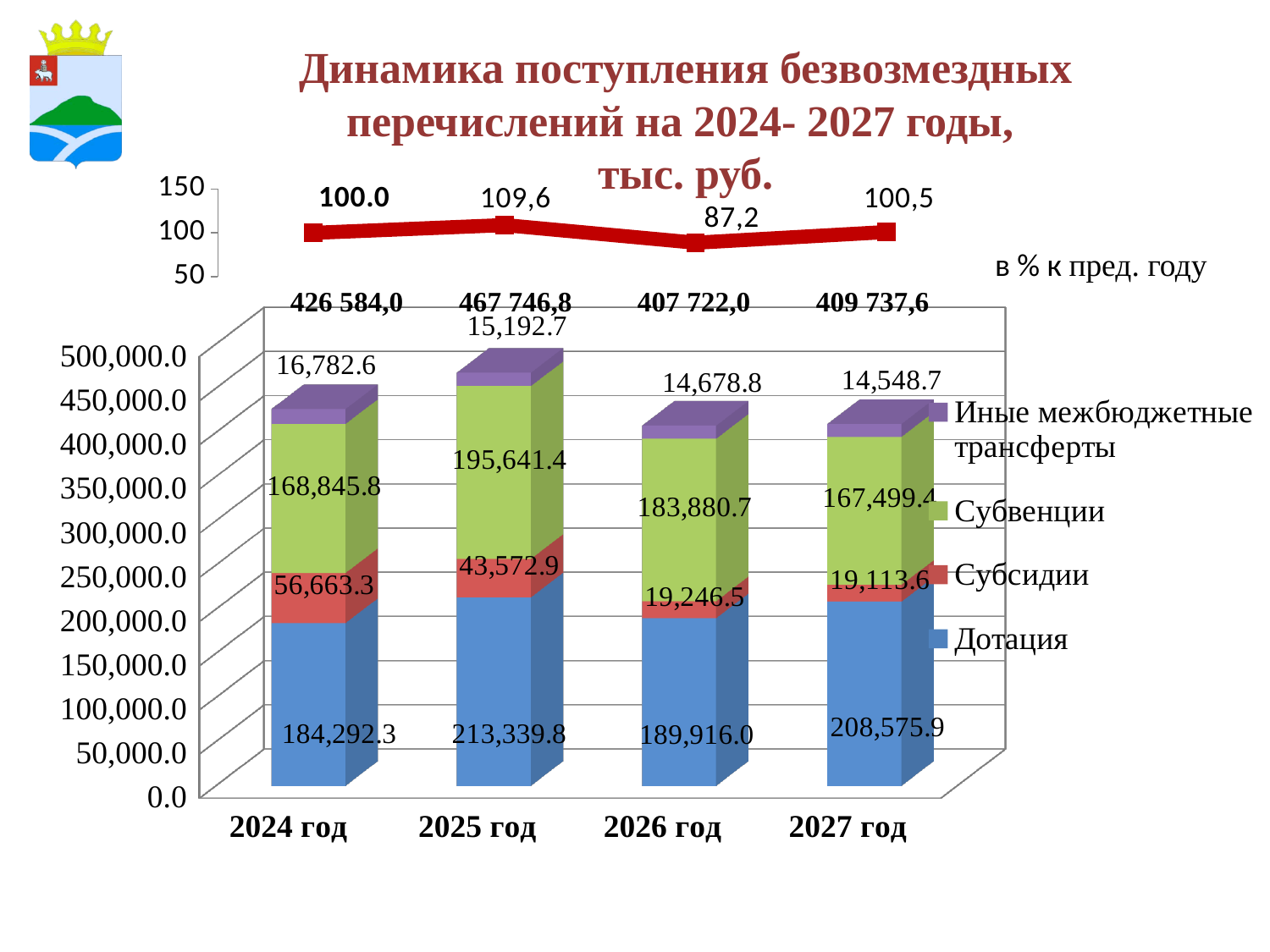
How many years are shown on the x axis of the stacked bar chart? 4 On the line chart at the top of the slide (в % к пред. году), what is the value for 2026? 87,2 On the stacked bar chart, what is the value of Дотация for 2025 год? 213,339.8 On the stacked bar chart, what is the difference between the Дотация values for 2025 год and 2024 год? 29,047.5 On the stacked bar chart, which year has the highest value for Субвенции? 2025 год On the line chart at the top of the slide (в % к пред. году), which year has the highest value? 2025 How many series does the legend of the stacked bar chart list? 4 On the stacked bar chart, what is the value of Иные межбюджетные трансферты for 2024 год? 16,782.6 On the stacked bar chart, is the Субсидии value larger in 2024 год or in 2025 год? 2024 год On the stacked bar chart, what is the total printed above the bar for 2025 год? 467 746,8 On the stacked bar chart, which year has the lowest value for Субсидии? 2027 год On the stacked bar chart, what is the value of Субвенции for 2026 год? 183,880.7